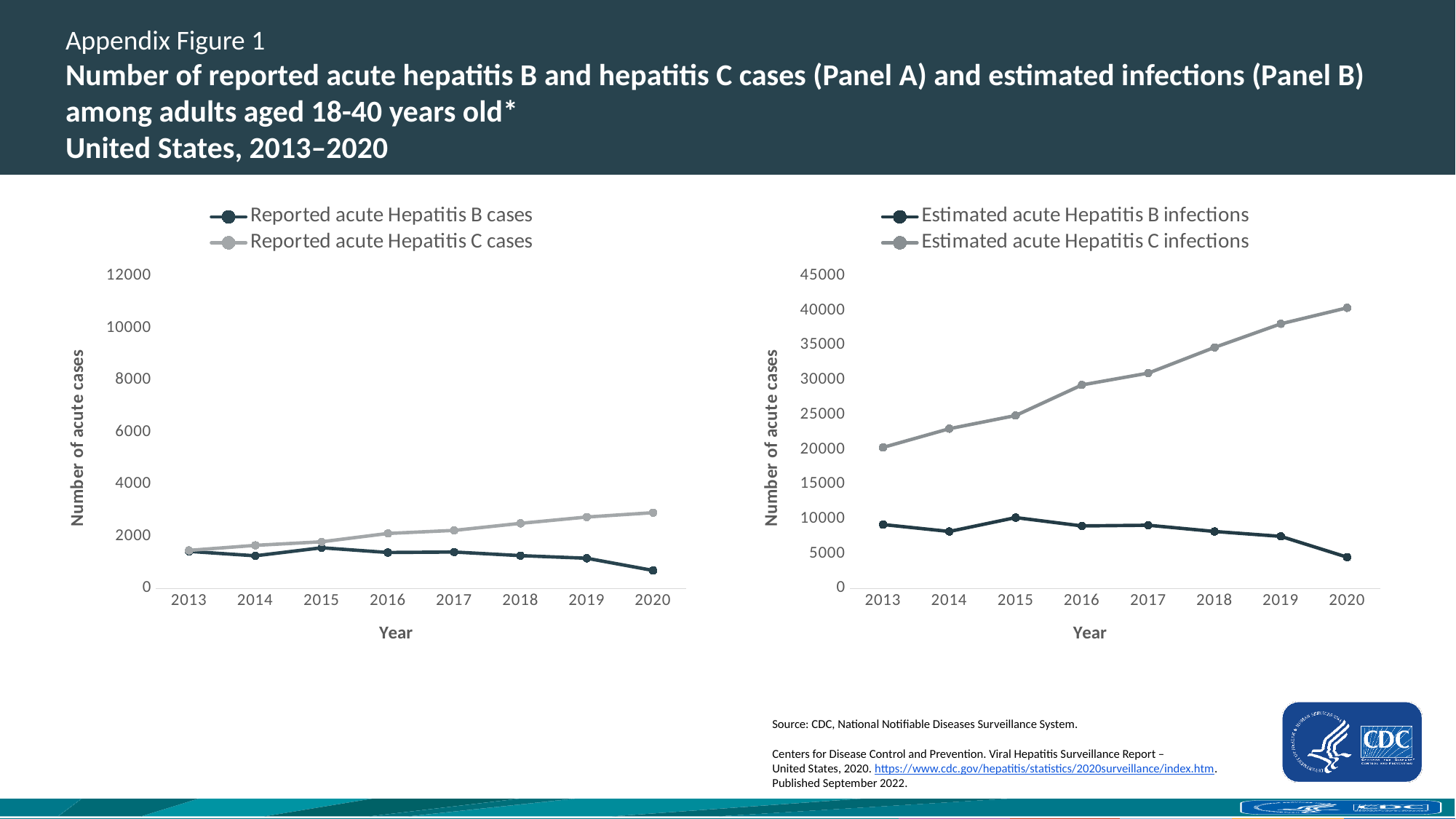
In the right chart (Panel B), which year has the highest number of Estimated acute Hepatitis C infections? 2020 In the left chart (Panel A), do the Reported acute Hepatitis B cases rise or fall from 2013 to 2020? fall How many series does the legend of the right chart (Panel B, estimated infections) list? 2 How many years are plotted along the x axis of the left chart (Panel A, reported cases)? 8 In the left chart (Panel A), which year has the highest number of Reported acute Hepatitis C cases? 2020 What kind of chart is the left chart (Panel A, reported cases)? line chart In the left chart (Panel A), is the value for Reported acute Hepatitis C cases in 2020 greater or less than 2000? greater In the right chart (Panel B), is the value for Estimated acute Hepatitis C infections in 2020 greater or less than 35000? greater In the left chart (Panel A), do the Reported acute Hepatitis C cases rise or fall from 2013 to 2020? rise In the left chart (Panel A), which year has the lowest number of Reported acute Hepatitis B cases? 2020 In the left chart (Panel A), in 2020, which series is larger: Reported acute Hepatitis B cases or Reported acute Hepatitis C cases? Reported acute Hepatitis C cases In the right chart (Panel B), which year has the lowest number of Estimated acute Hepatitis B infections? 2020